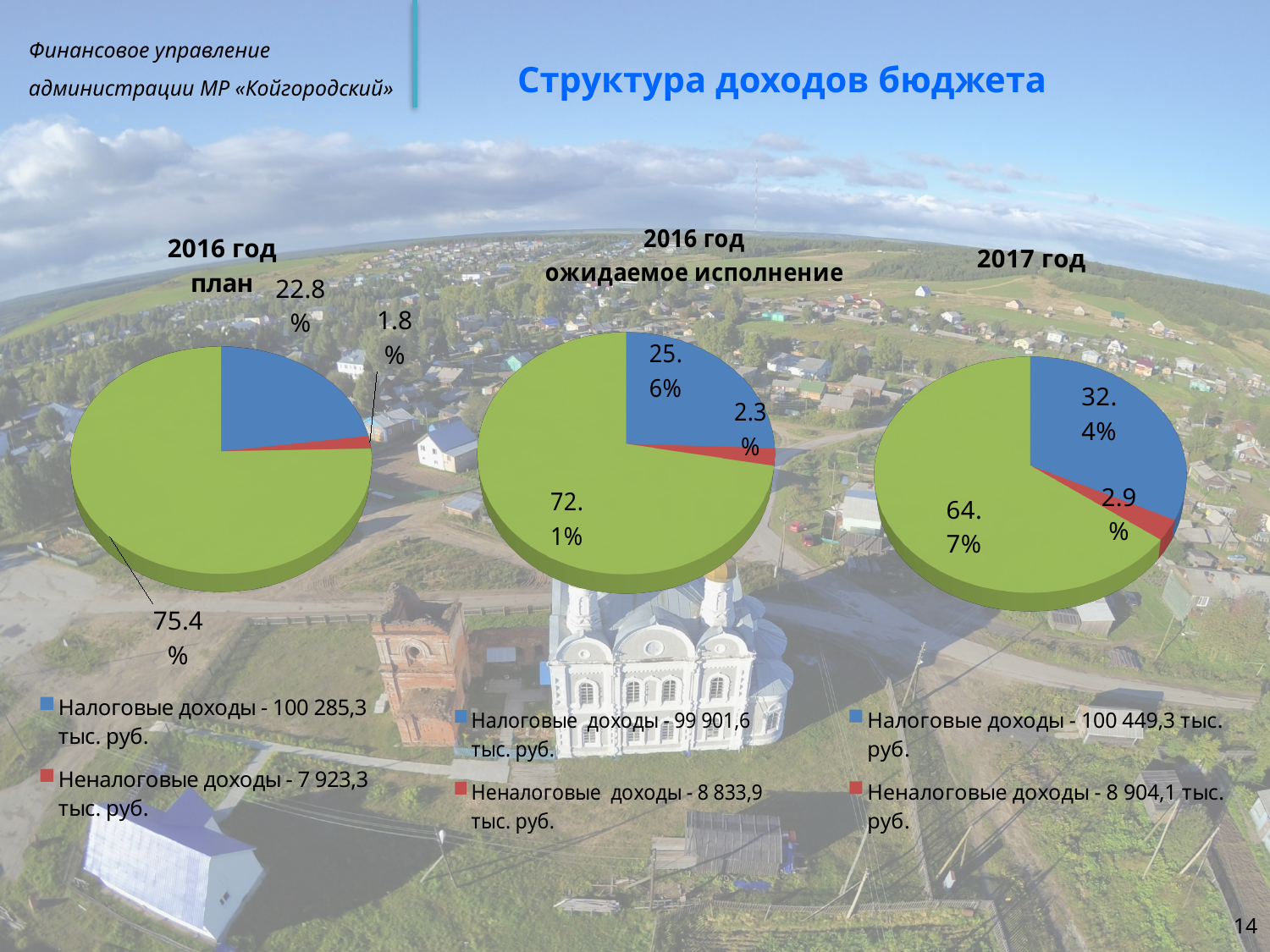
In the "2017 год" chart, what percentage is shown for the largest (green) slice? 64.7% In the "2016 год ожидаемое исполнение" chart, which slice is the largest? The green slice (72.1%) In the "2016 год план" chart, which slice is the smallest? Неналоговые доходы (1.8%) How many entries does the legend of the "2017 год" chart list? 2 What is the difference between the Налоговые доходы share in the "2017 год" chart (32.4%) and in the "2016 год план" chart (22.8%)? 9.6 percentage points In the "2016 год ожидаемое исполнение" chart, what percentage is shown for the red slice (Неналоговые доходы)? 2.3% In the "2017 год" chart, what percentage is shown for the blue slice (Налоговые доходы)? 32.4% According to the legend of the "2016 год ожидаемое исполнение" chart, what amount is given for Налоговые доходы? 99 901,6 тыс. руб. How many slices does the "2016 год ожидаемое исполнение" pie chart have? 3 Which chart shows a larger share for Неналоговые доходы: "2016 год план" or "2017 год"? 2017 год What kind of chart is used for "2016 год план"? Pie chart